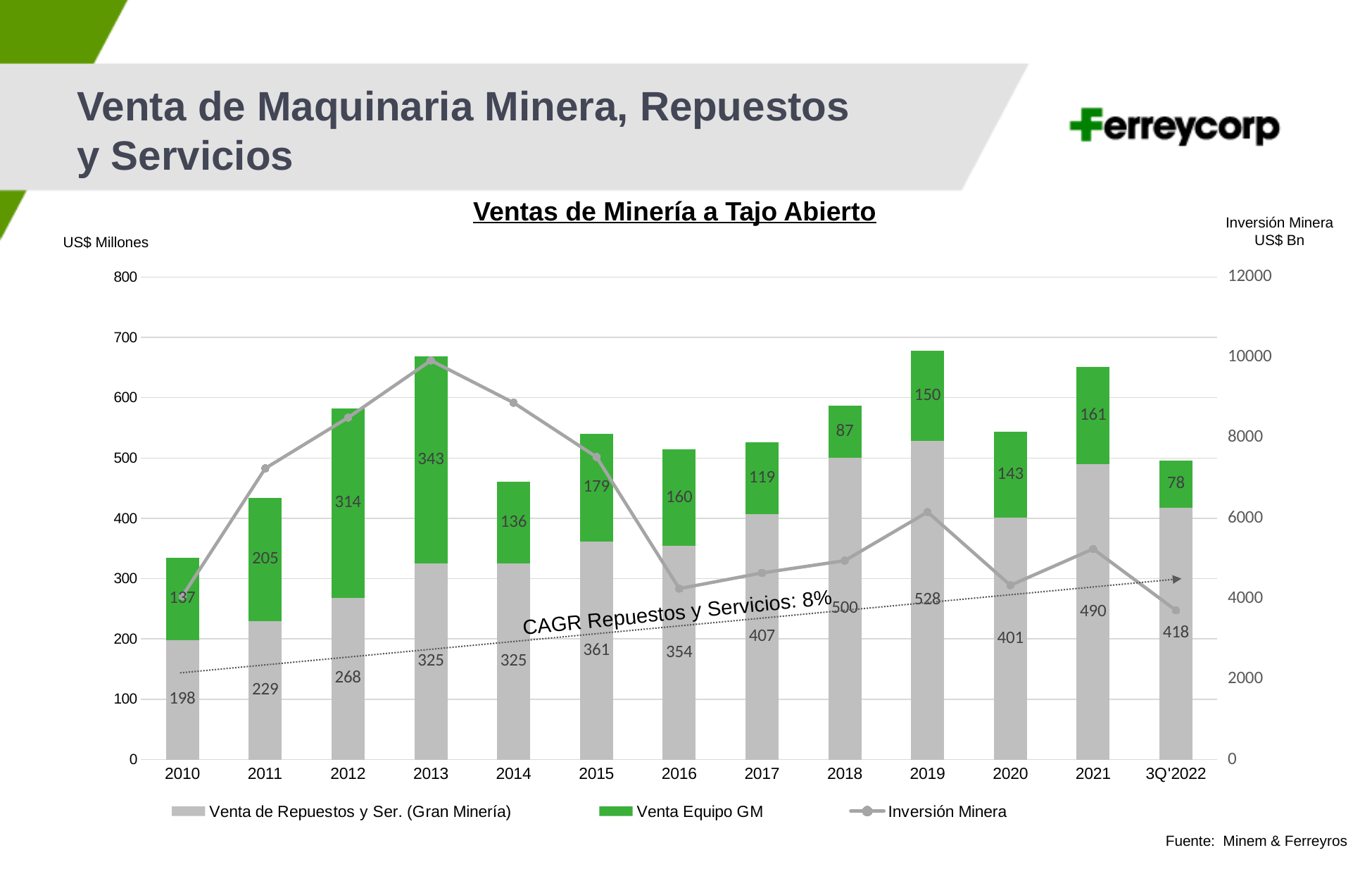
In which year is Venta Equipo GM highest? 2013 What is the difference between Venta de Repuestos y Ser. (Gran Minería) in 2021 and in 3Q'2022? 72 Is the Inversión Minera value for 2013 greater or less than 8000? greater What type of chart is shown on the slide? Stacked bar chart with a line In which period is Venta Equipo GM lowest? 3Q'2022 How many series does the legend list? 3 What is the value of Venta de Repuestos y Ser. (Gran Minería) in 2018? 500 What is the total of the stacked bar for 2019? 678 What is the value of Venta Equipo GM in 2013? 343 How many periods are shown on the x axis? 13 In which year is Venta de Repuestos y Ser. (Gran Minería) highest? 2019 Which is larger: Venta Equipo GM in 2012 or in 2014? 2012